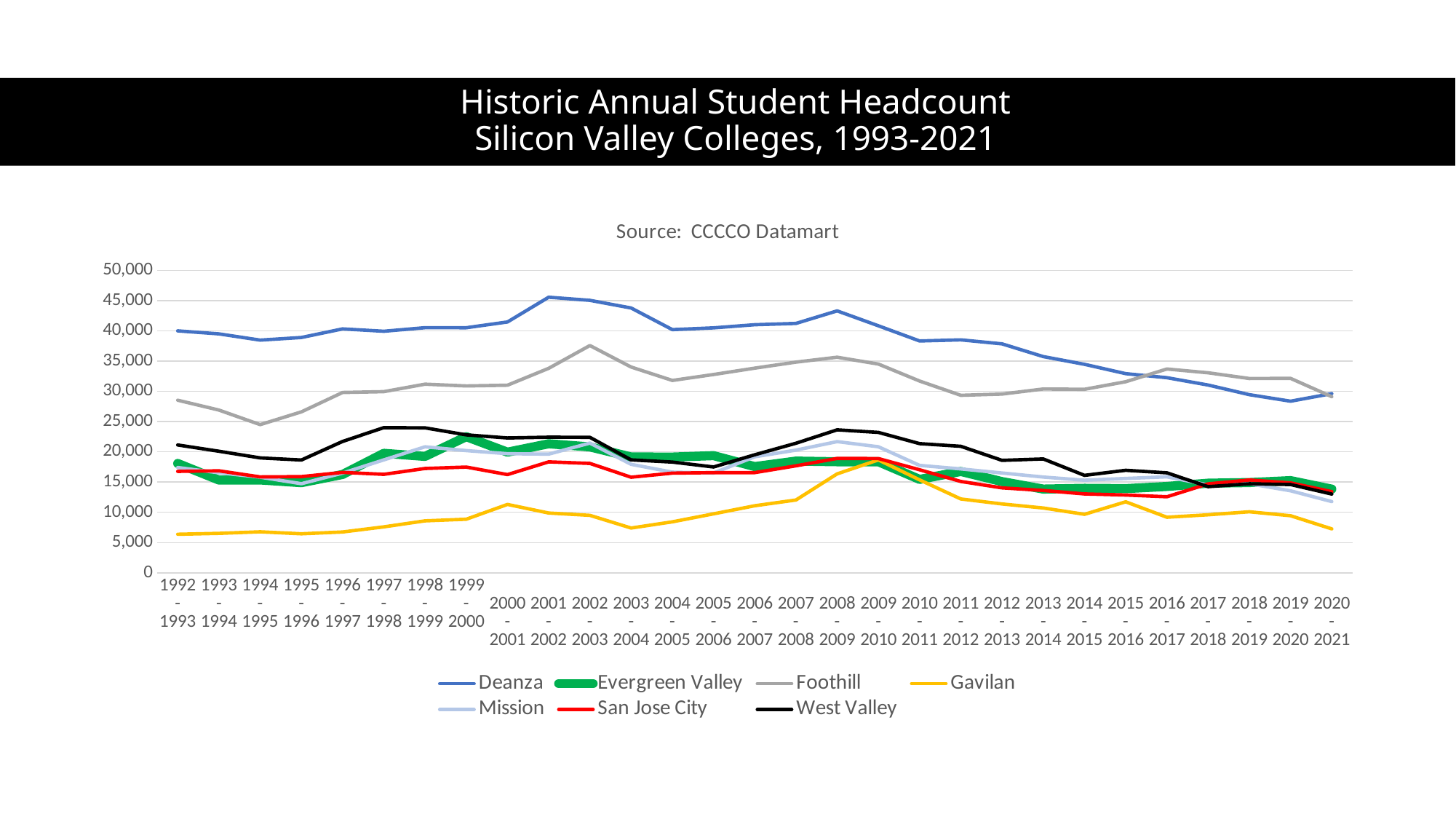
Is the value for Gavilan in 1992-1993 greater or less than 10,000? less In 2008-2009, which is larger, the headcount for Foothill or for West Valley? Foothill Is the value for Deanza in 2001-2002 greater or less than 40,000? greater How many series does the legend list? 7 How many academic years are plotted along the x axis? 29 Is the value for Deanza in 2016-2017 greater or less than 30,000? greater What source is cited for the chart data? CCCCO Datamart What kind of chart is shown on the slide? line chart Does the Deanza headcount rise or fall from 2008-2009 to 2019-2020? fall